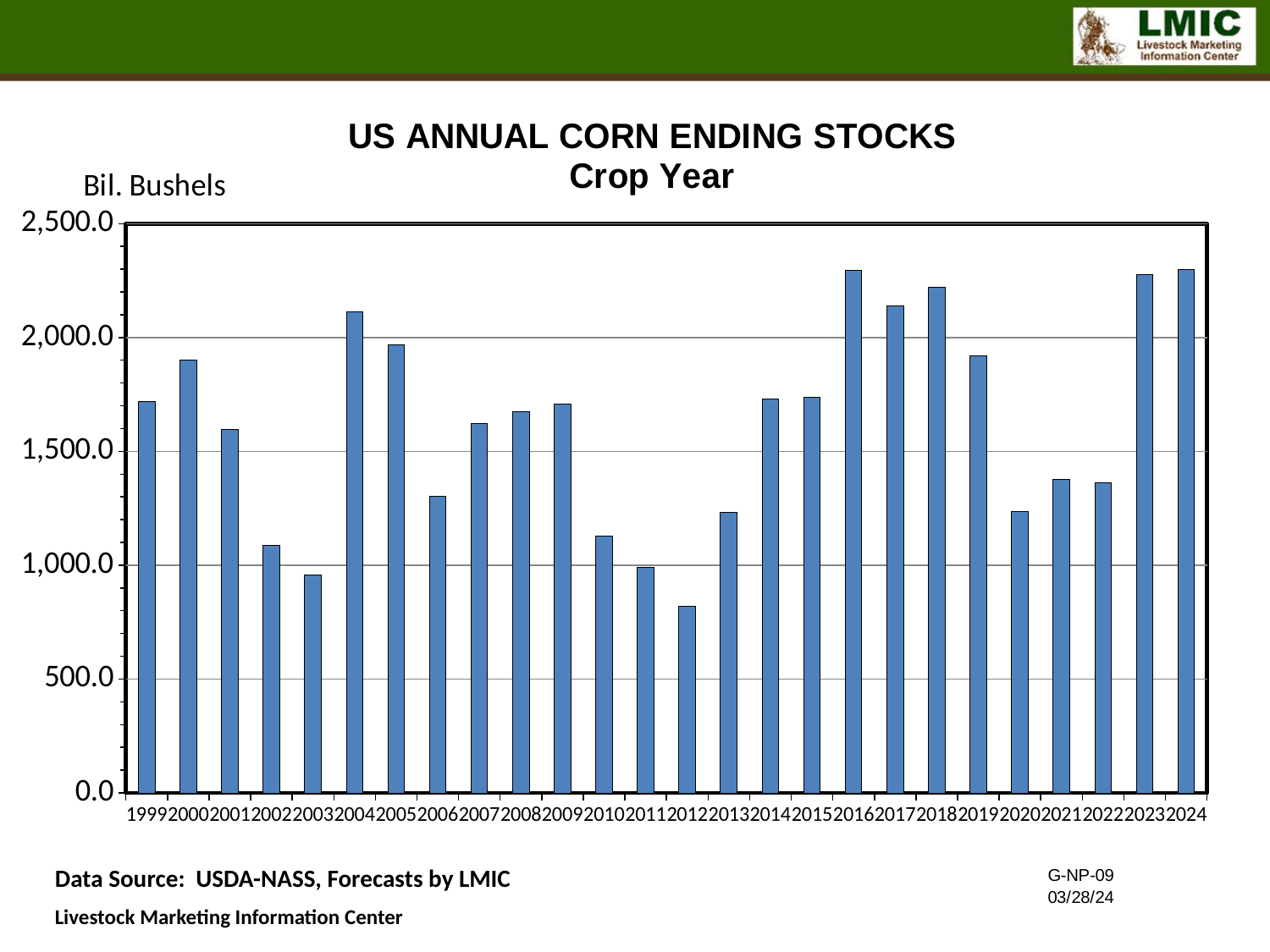
Which crop year has higher corn ending stocks, 2019 or 2020? 2019 Is the value for 2003 greater or less than 1,000.0? less Is the value for 2020 greater or less than 1,500.0? less Is the value for 2016 greater or less than 2,000.0? greater What unit is shown on the vertical axis of the chart? Bil. Bushels What kind of chart is shown on the slide? Bar chart Do corn ending stocks rise or fall from 2009 to 2012? Fall Which crop year has higher corn ending stocks, 2004 or 2005? 2004 Which crop year has the lowest corn ending stocks? 2012 How many crop years are plotted on the chart? 26